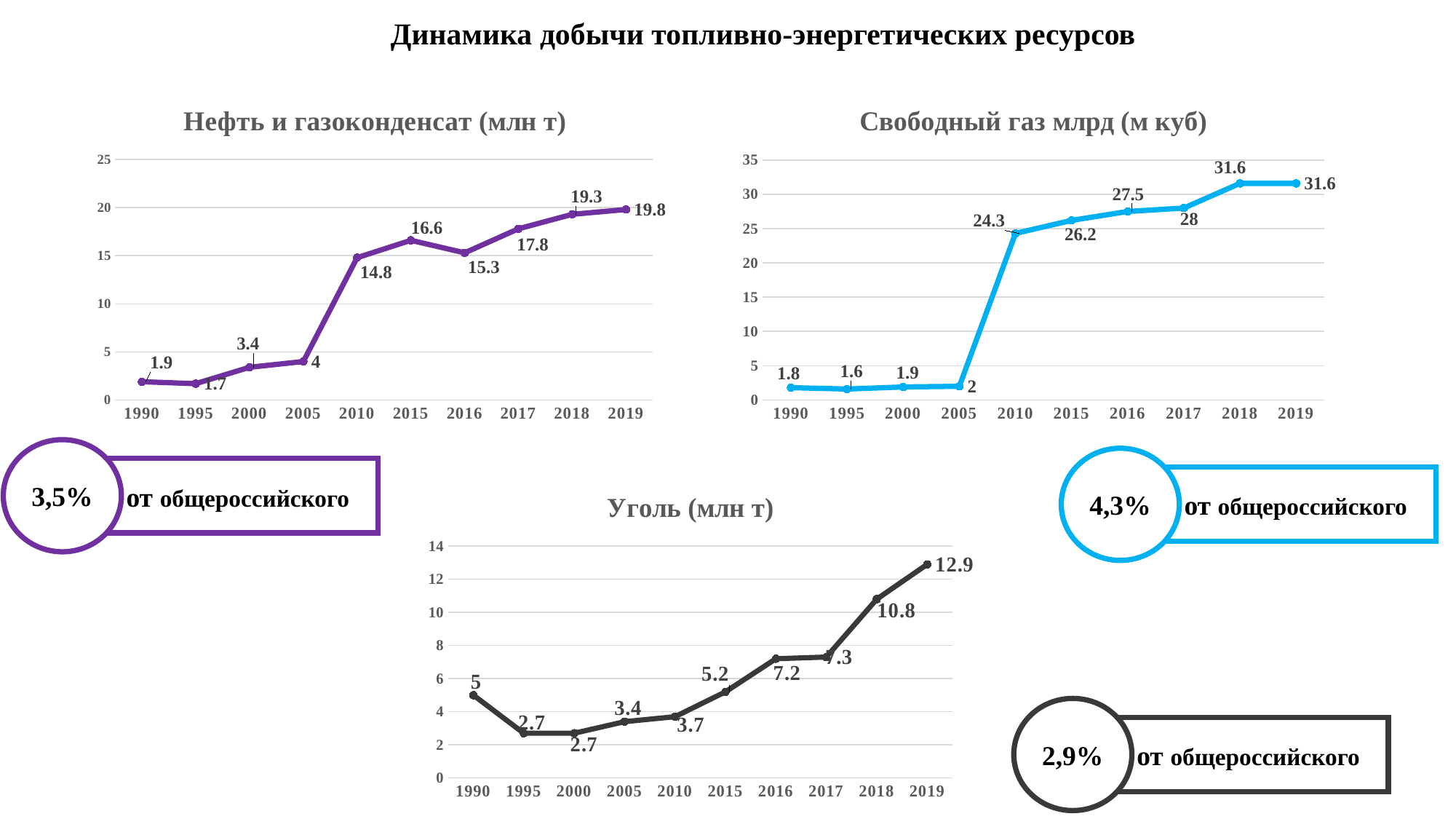
In the chart titled "Свободный газ млрд (м куб)", which year has the lowest value? 1995 In the chart titled "Уголь (млн т)", what is the value for 2018? 10.8 In the chart titled "Уголь (млн т)", which is larger, the value for 1990 or the value for 2015? 2015 In the chart titled "Нефть и газоконденсат (млн т)", what is the value for 2010? 14.8 In the chart titled "Нефть и газоконденсат (млн т)", what is the difference between the values for 2019 and 2018? 0.5 In the chart titled "Уголь (млн т)", which year has the highest value? 2019 In the chart titled "Свободный газ млрд (м куб)", what is the value for 2015? 26.2 In the chart titled "Уголь (млн т)", do the values rise or fall from 2015 to 2019? rise In the chart titled "Нефть и газоконденсат (млн т)", which year has the lowest value? 1995 What kind of chart is the chart titled "Свободный газ млрд (м куб)"? line chart How many data points are plotted in the chart titled "Уголь (млн т)"? 10 In the chart titled "Свободный газ млрд (м куб)", what is the difference between the values for 2010 and 2005? 22.3